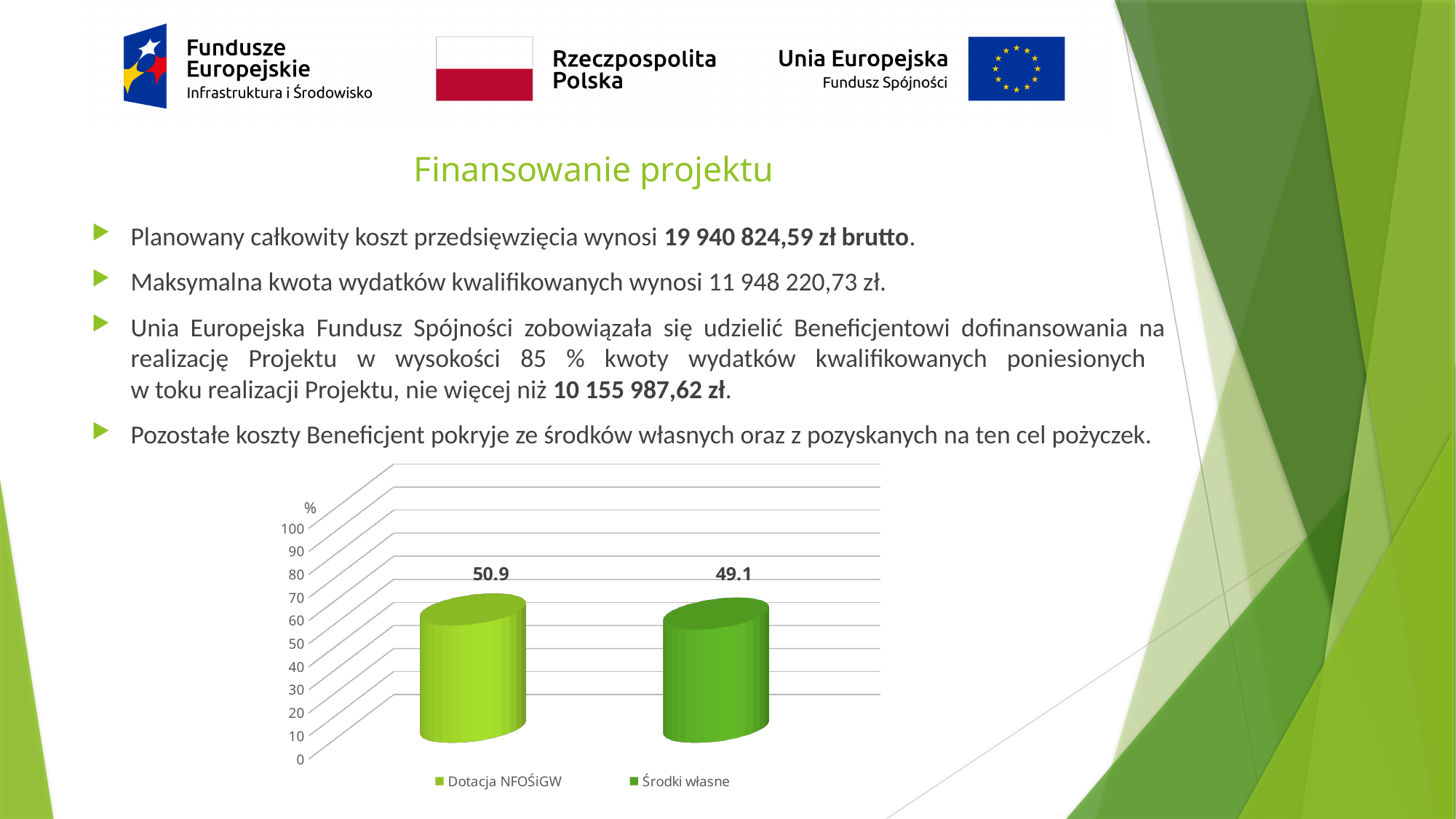
How many series does the chart legend list? 2 What is the value shown for Dotacja NFOŚiGW in the chart? 50.9 What is the value shown for Środki własne in the chart? 49.1 Which series has the highest value in the chart? Dotacja NFOŚiGW Is the value for Dotacja NFOŚiGW greater or less than 50? greater Which series has the higher value in the chart, Dotacja NFOŚiGW or Środki własne? Dotacja NFOŚiGW Which series has the lowest value in the chart? Środki własne What kind of chart is shown on the slide? Bar chart Is the value for Środki własne greater or less than 50? less What is the difference between the values for Dotacja NFOŚiGW and Środki własne? 1.8 What unit is shown on the vertical axis of the chart? % What is the maximum value shown on the vertical axis of the chart? 100